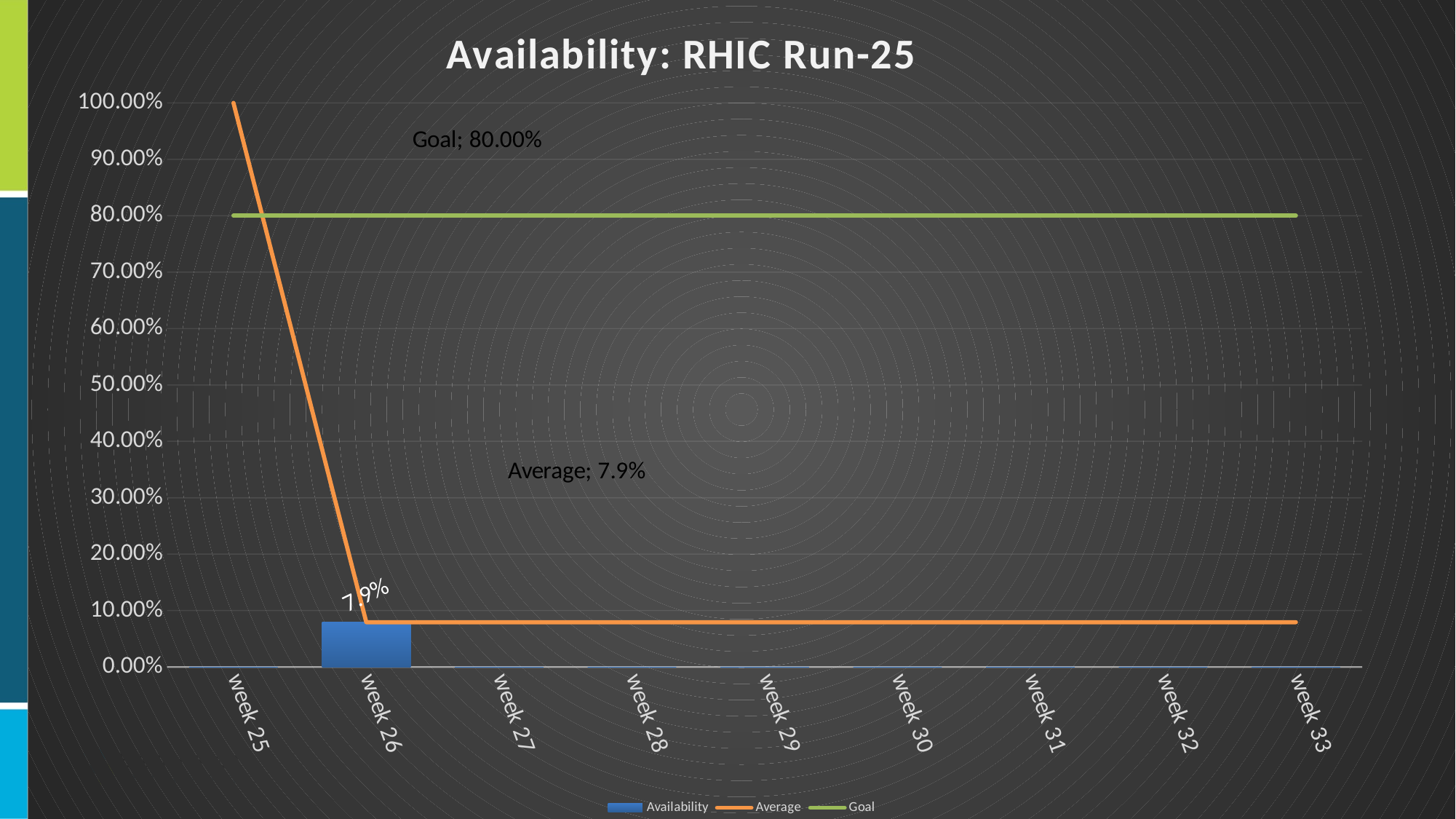
What value does the Average label show? 7.9% What is the Availability value for week 26? 7.9% How many weeks are shown on the x axis? 9 How many series does the legend list? 3 Is the Average value at week 25 greater or less than 90.00%? greater Which week has the highest Availability bar? week 26 What is the difference between the Goal value and the Availability value for week 26? 72.1% What kind of chart is this? bar and line chart What value is the Goal line set at? 80.00% Which is larger, the Goal value or the Availability value for week 26? Goal Does the Average line rise or fall from week 25 to week 26? fall What is the title of the chart? Availability: RHIC Run-25